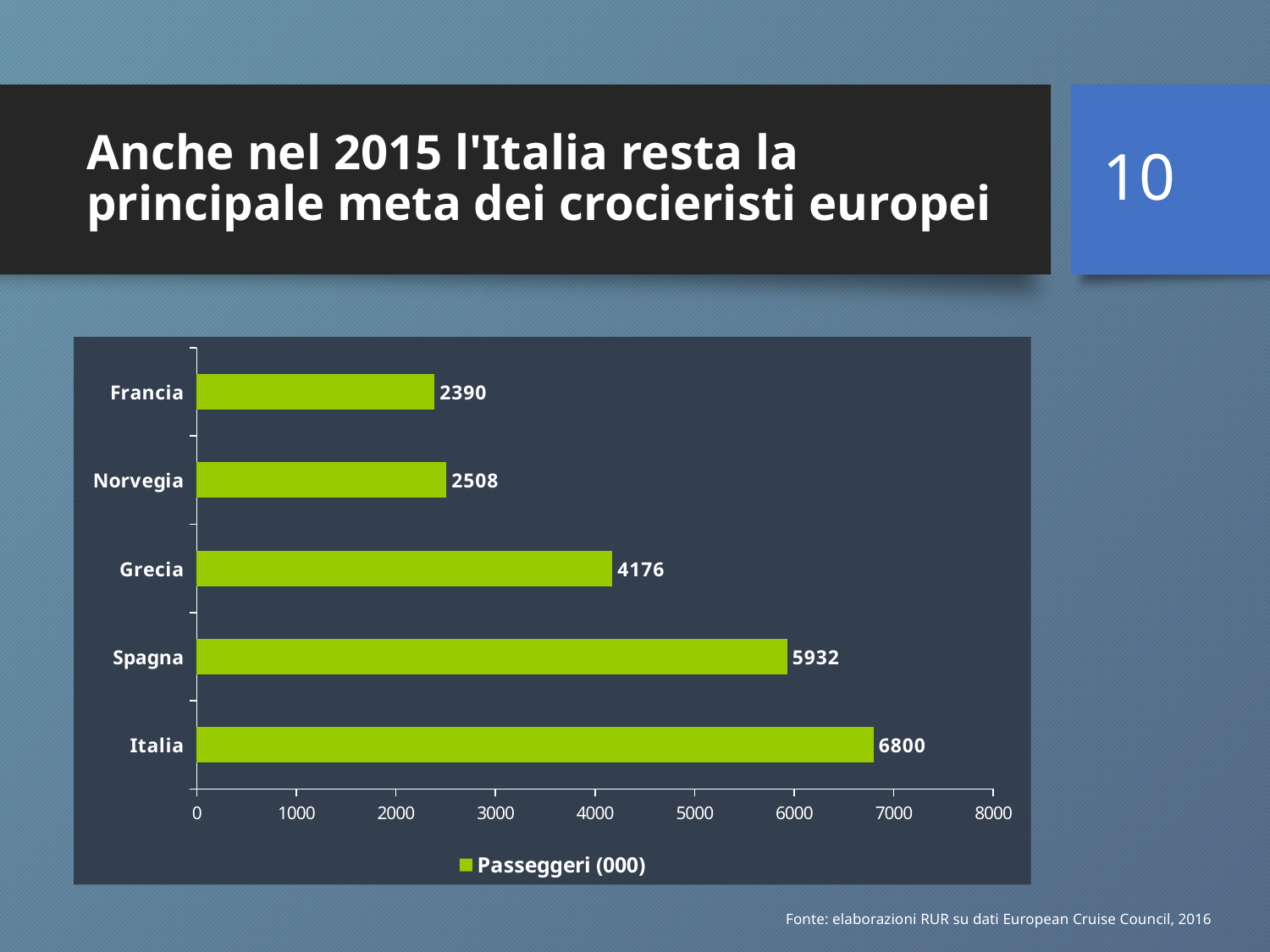
How many countries are shown in the chart? 5 Which country has the lowest value? Francia What is the difference between the values for Norvegia and Francia? 118 Is the value for Spagna greater or less than 5000? greater What kind of chart is shown on the slide? bar chart Which country has the highest value? Italia What is the value for Norvegia? 2508 What series does the legend list? Passeggeri (000) What is the difference between the values for Italia and Spagna? 868 What is the value for Italia? 6800 Which is larger, the value for Grecia or the value for Norvegia? Grecia What is the value for Grecia? 4176